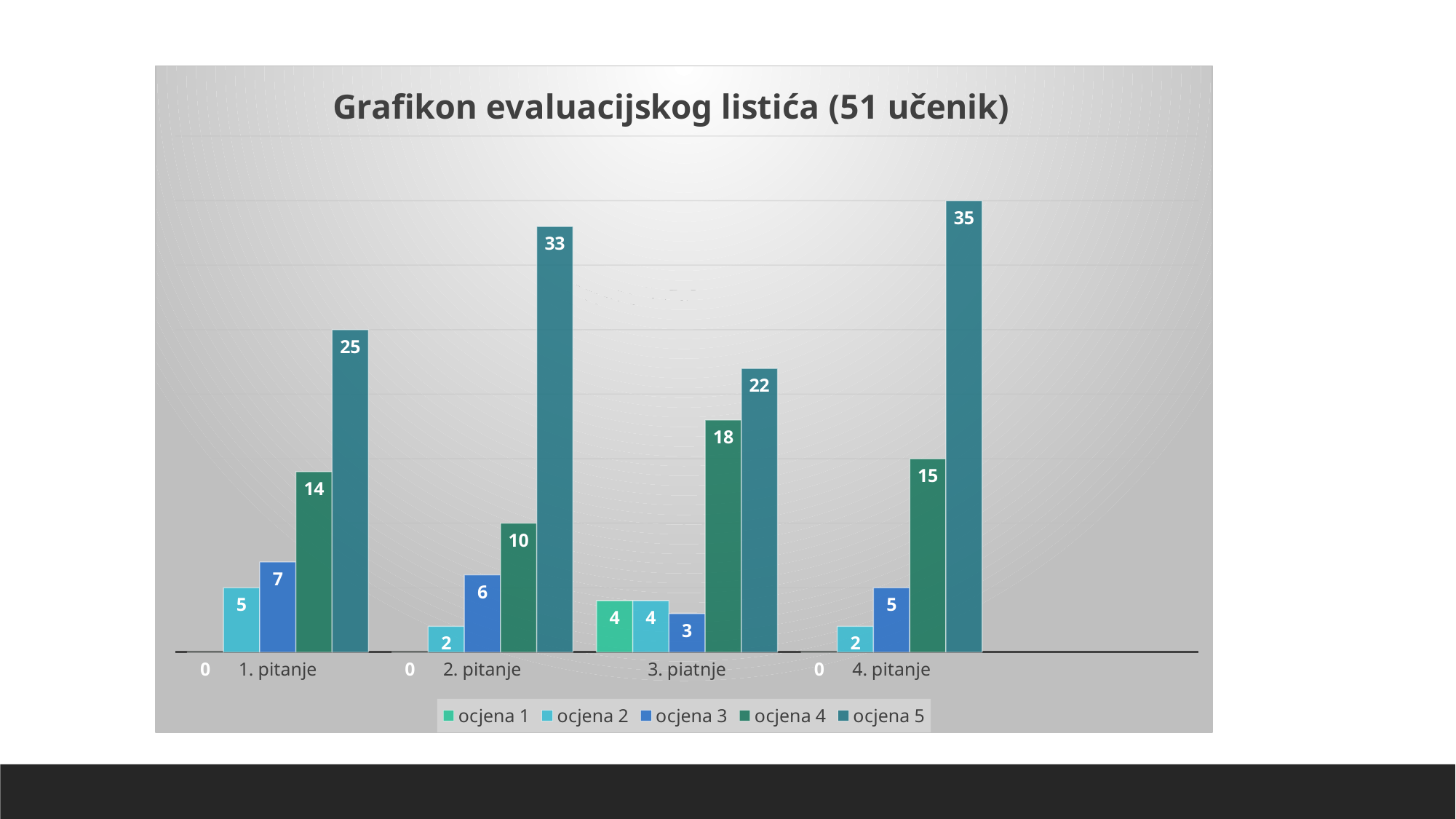
Which is larger: ocjena 3 in 1. pitanje or ocjena 3 in 2. pitanje? ocjena 3 in 1. pitanje What is the value for ocjena 1 in 3. piatnje? 4 How many series does the legend list? 5 What is the value for ocjena 2 in 1. pitanje? 5 How many categories are shown on the x axis? 4 Which category has the highest value for ocjena 5? 4. pitanje Which category has the lowest value for ocjena 4? 2. pitanje What is the title of the chart? Grafikon evaluacijskog listića (51 učenik) What kind of chart is shown on the slide? bar chart What is the value for ocjena 5 in 2. pitanje? 33 What is the difference between the ocjena 5 values for 4. pitanje and 1. pitanje? 10 What is the value for ocjena 4 in 3. piatnje? 18